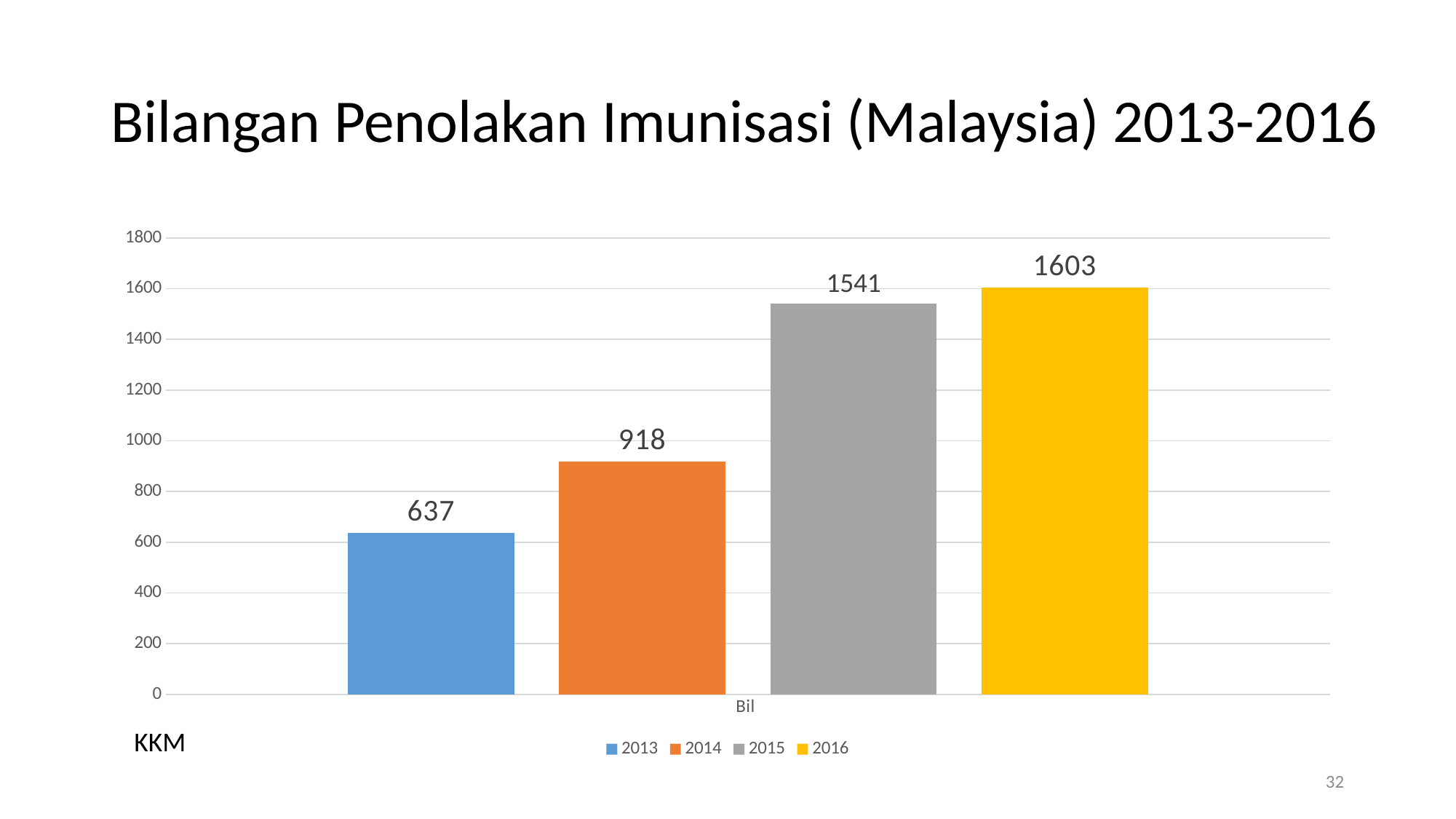
What is the value for 2013? 637 What is the difference between the values for 2016 and 2015? 62 What is the value for 2016? 1603 Which year has the highest value? 2016 What is the title of the chart? Bilangan Penolakan Imunisasi (Malaysia) 2013-2016 What kind of chart is shown on the slide? bar chart Which is larger, the value for 2014 or the value for 2015? 2015 What is the difference between the values for 2014 and 2013? 281 Which year has the lowest value? 2013 What is the value for 2015? 1541 How many series does the legend list? 4 Is the value for 2014 greater or less than 1000? less